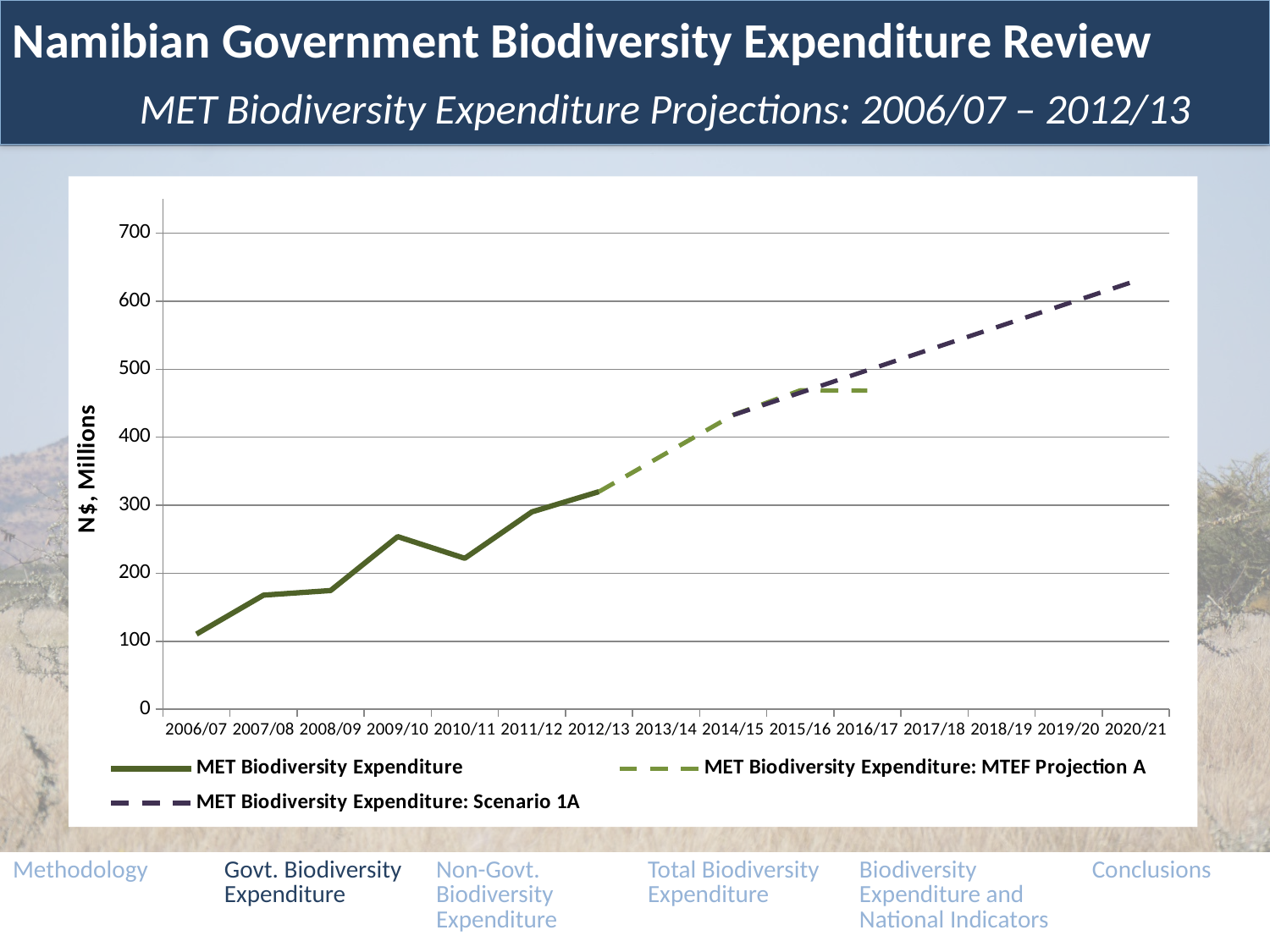
How many fiscal years are shown along the x axis? 15 In which year is the MET Biodiversity Expenditure (solid line) lowest? 2006/07 Does the MET Biodiversity Expenditure: Scenario 1A series rise or fall from 2012/13 to 2020/21? rise Which year has the larger MET Biodiversity Expenditure, 2009/10 or 2010/11? 2009/10 What kind of chart is shown on the slide? line chart How many series does the legend list? 3 Is the MET Biodiversity Expenditure for 2006/07 greater or less than 200? less What is the label of the y axis? N$, Millions In which year is the MET Biodiversity Expenditure (solid line) highest? 2012/13 Is the MET Biodiversity Expenditure: Scenario 1A value for 2020/21 greater or less than 600? greater Is the MET Biodiversity Expenditure for 2012/13 greater or less than 300? greater Which series is drawn as a solid line? MET Biodiversity Expenditure